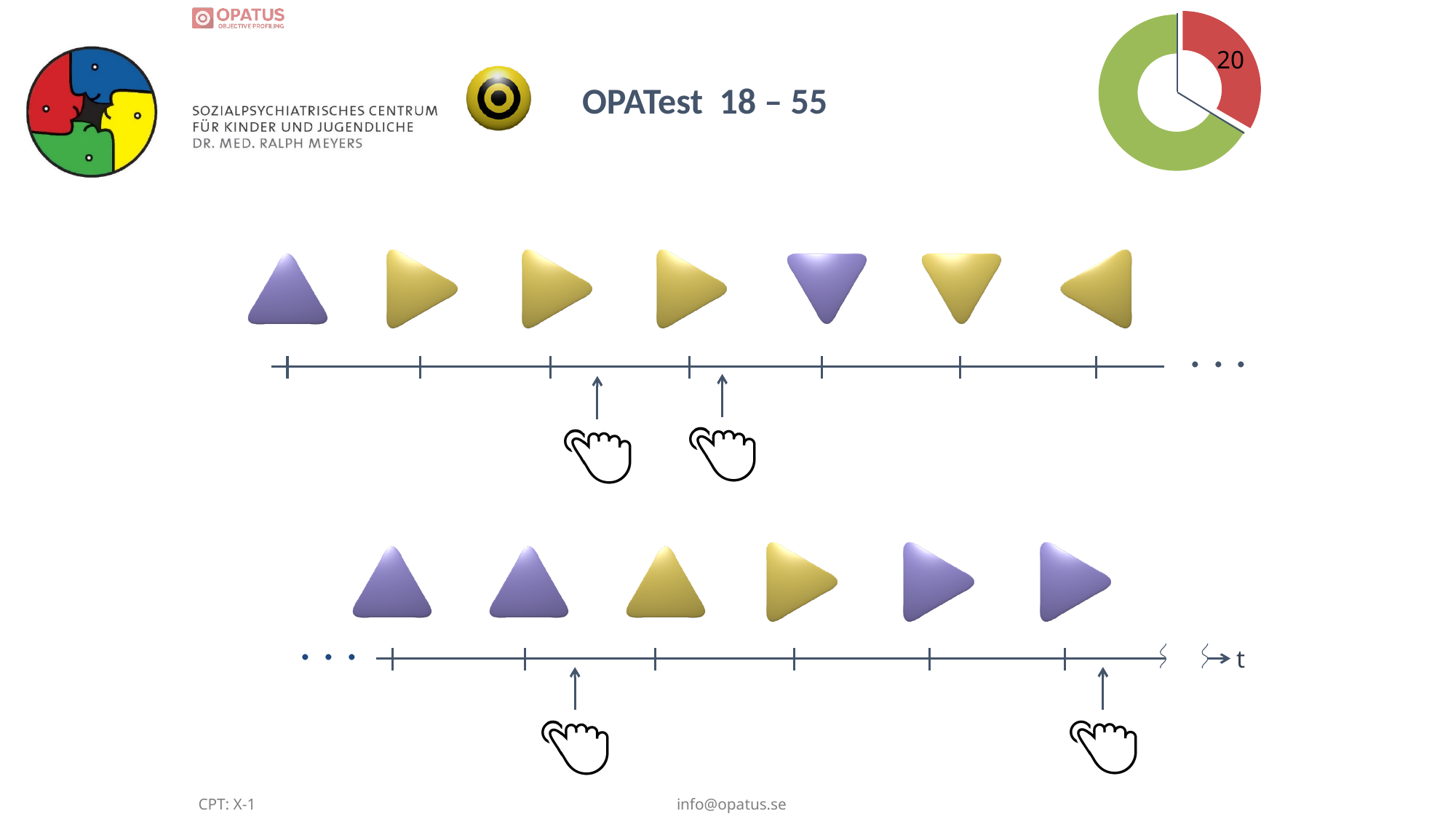
In the donut chart in the top right, which slice is larger, the green one or the red one? green In the donut chart in the top right, does the red slice cover more or less than half of the ring? less In the donut chart in the top right, which colour is the smallest slice? red How many slices does the donut chart in the top right have? 2 In the donut chart in the top right, what value is printed on the red slice? 20 In the donut chart in the top right, which slice has a value label printed on it? the red slice In the donut chart in the top right, which colour is the largest slice? green What kind of chart is shown in the top right corner of the slide? Donut (pie) chart